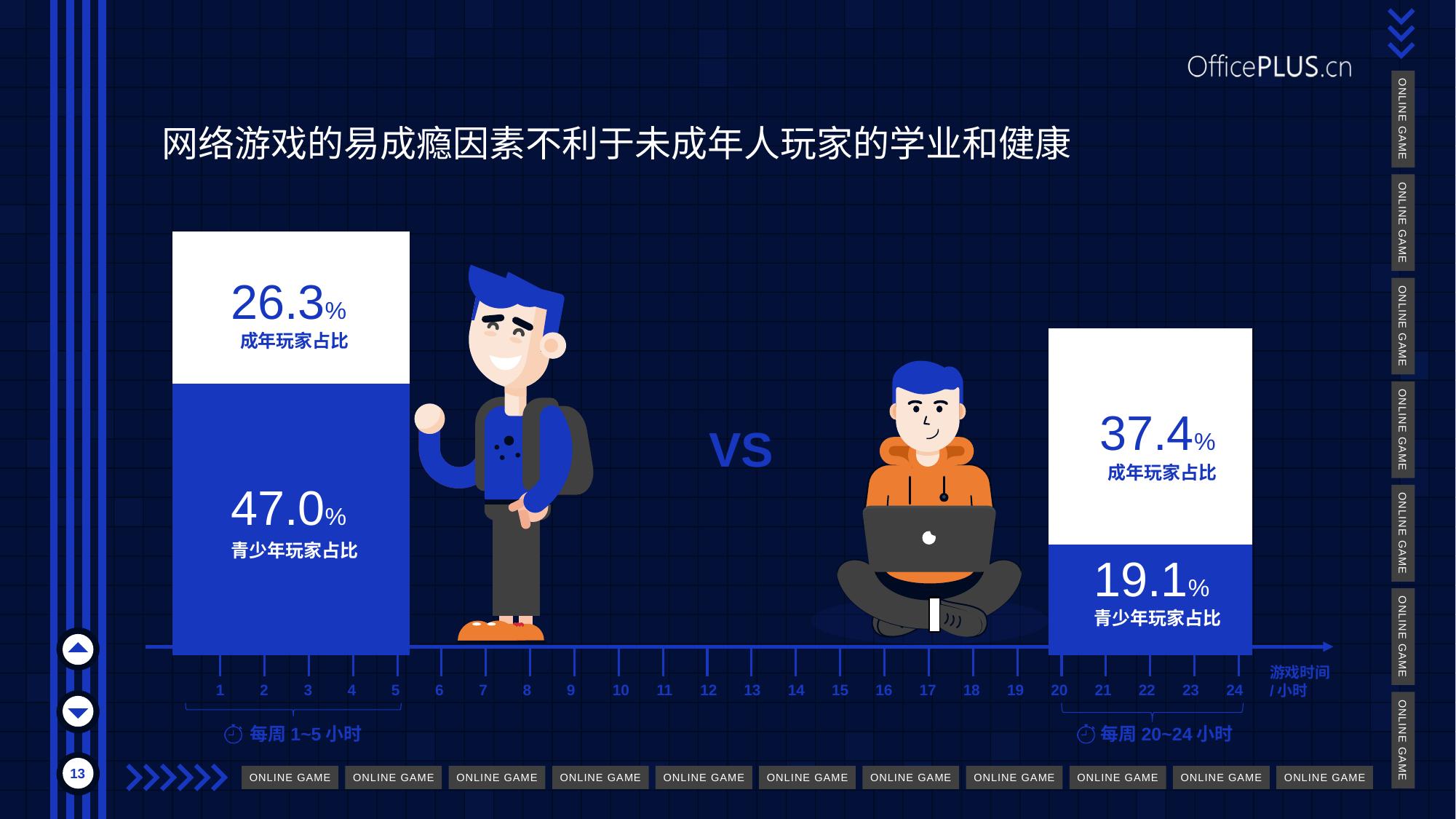
How many weekly gaming-time groups are shown on the chart? 2 What is the label of the horizontal axis of the chart? 游戏时间 / 小时 What is the 成年玩家占比 for the 每周 20~24 小时 group? 37.4% What is the 青少年玩家占比 for the 每周 1~5 小时 group? 47.0% Which group has the higher 青少年玩家占比, 每周 1~5 小时 or 每周 20~24 小时? 每周 1~5 小时 How much higher is the 青少年玩家占比 for 每周 1~5 小时 than for 每周 20~24 小时? 27.9% What is the difference between the 青少年玩家占比 and the 成年玩家占比 in the 每周 1~5 小时 group? 20.7% What is the 成年玩家占比 for the 每周 1~5 小时 group? 26.3% Which group has the higher 成年玩家占比, 每周 1~5 小时 or 每周 20~24 小时? 每周 20~24 小时 What is the difference between the 成年玩家占比 and the 青少年玩家占比 in the 每周 20~24 小时 group? 18.3% What kind of chart is shown on the slide? Bar chart What is the 青少年玩家占比 for the 每周 20~24 小时 group? 19.1%